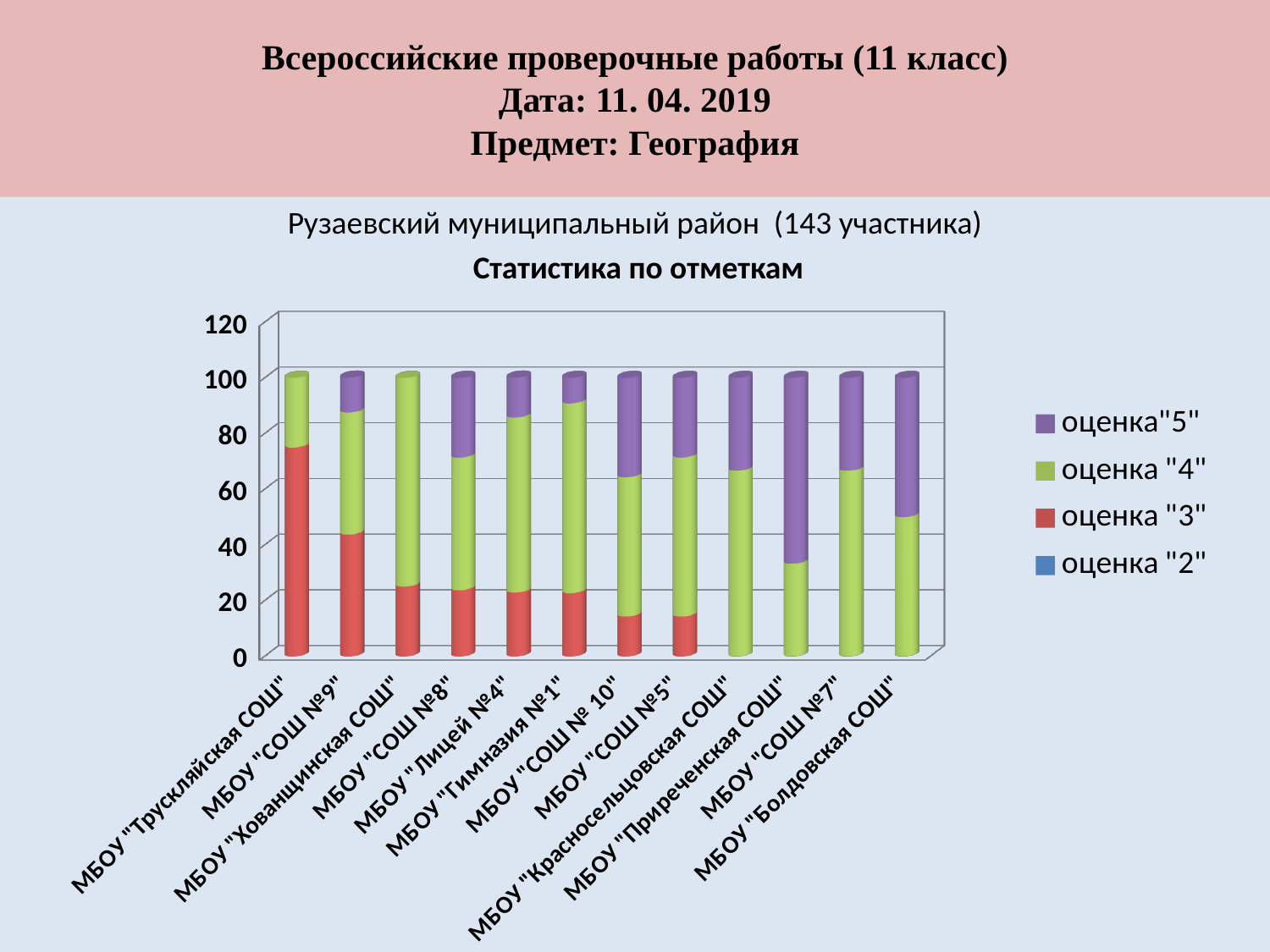
Which school has the largest оценка "5" segment? МБОУ "Приреченская СОШ" Which school has the largest оценка "3" segment? МБОУ "Трускляйская СОШ" What is the total height of the stacked bar for МБОУ "СОШ №9"? 100 Is the оценка "3" value for МБОУ "СОШ №9" greater or less than 60? less What is the title of the chart? Статистика по отметкам Is the оценка "3" value for МБОУ "Трускляйская СОШ" greater or less than 60? greater How many series does the legend of the chart list? 4 Is the оценка "4" value for МБОУ "Приреченская СОШ" greater or less than 40? less Which colour represents оценка "5" in the chart? purple Which is larger: the оценка "5" segment for МБОУ "Приреченская СОШ" or for МБОУ "СОШ №9"? МБОУ "Приреченская СОШ" What kind of chart is shown on the slide? stacked bar chart How many schools (categories) are shown on the x axis of the chart? 12